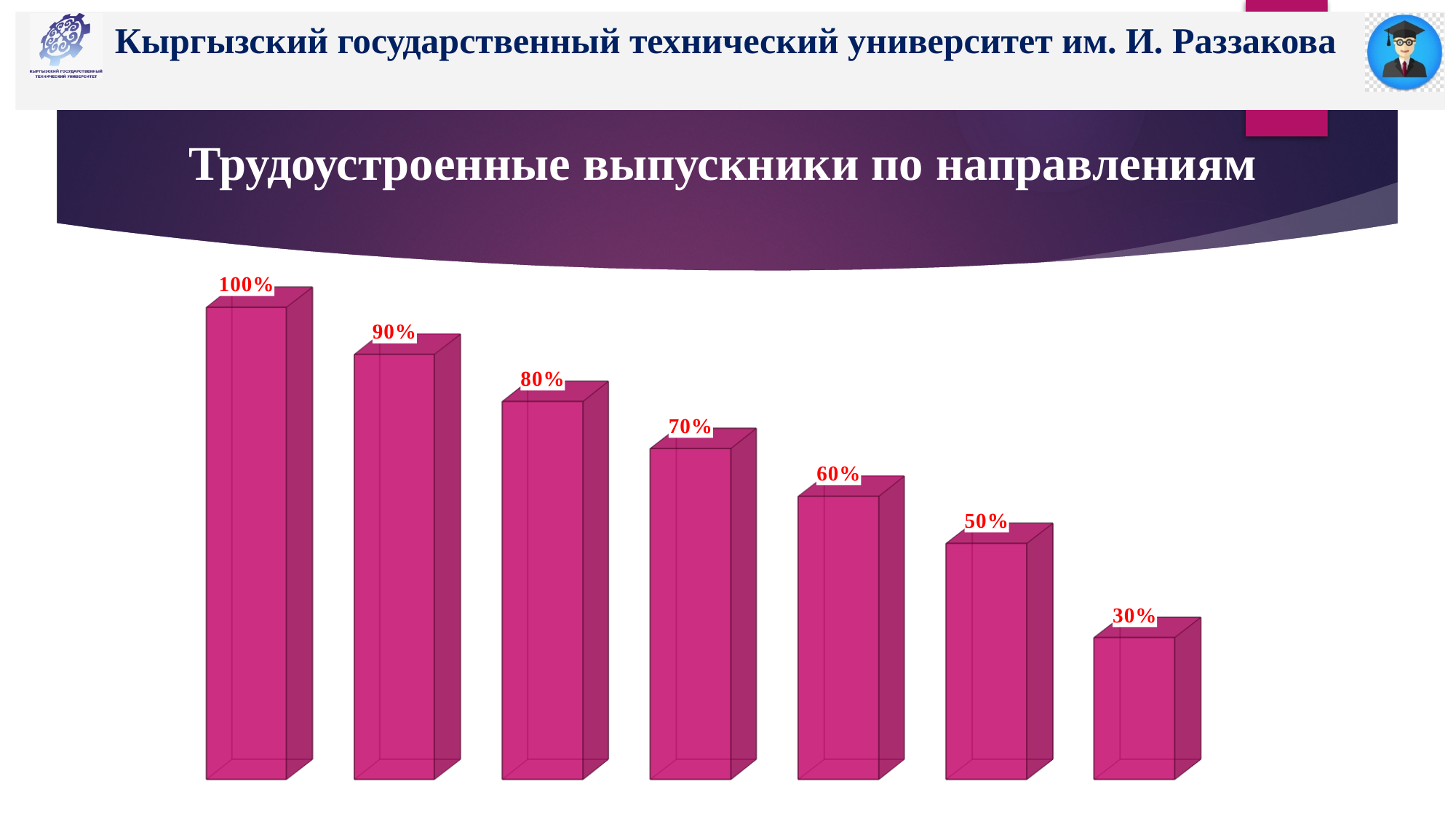
What is the value shown on the rightmost bar? 30% What is the lowest value shown on the chart? 30% What is the value shown on the fourth bar from the left? 70% What is the highest value shown on the chart? 100% What is the value shown on the second bar from the left? 90% What is the value shown on the leftmost bar? 100% What kind of chart is shown on the slide? bar chart Which is larger, the third bar from the left or the sixth bar from the left? the third bar (80%) Do the bar values rise or fall from left to right? fall How many bars does the chart contain? 7 What is the title of the chart? Трудоустроенные выпускники по направлениям What is the difference between the leftmost bar and the rightmost bar? 70%